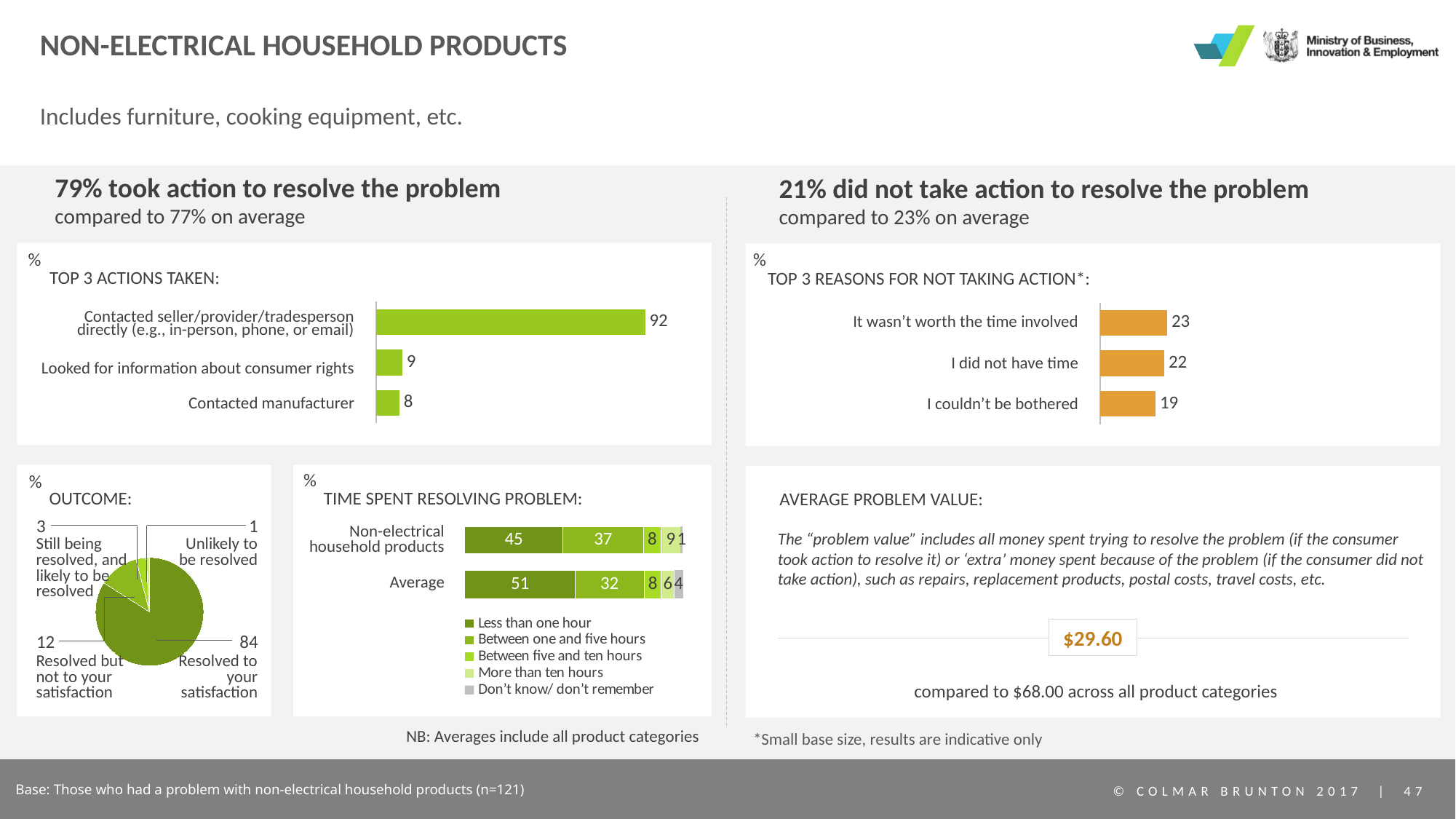
In the 'OUTCOME' pie chart, which outcome has the smallest slice? Unlikely to be resolved In the 'TOP 3 ACTIONS TAKEN' chart, what is the value for 'Contacted seller/provider/tradesperson directly'? 92 In the 'TOP 3 ACTIONS TAKEN' chart, which action has the lowest value? Contacted manufacturer What kind of chart is the 'OUTCOME' chart? Pie chart In the 'TOP 3 ACTIONS TAKEN' chart, what is the difference between 'Contacted seller/provider/tradesperson directly' and 'Looked for information about consumer rights'? 83 In the 'TIME SPENT RESOLVING PROBLEM' chart, what is the value for 'Less than one hour' for Non-electrical household products? 45 In the 'TIME SPENT RESOLVING PROBLEM' chart, how many series does the legend list? 5 In the 'TIME SPENT RESOLVING PROBLEM' chart, which is larger for 'Between one and five hours': Non-electrical household products or Average? Non-electrical household products In the 'TOP 3 REASONS FOR NOT TAKING ACTION' chart, what is the value for 'I did not have time'? 22 In the 'OUTCOME' pie chart, what is the value for 'Resolved to your satisfaction'? 84 In the 'TOP 3 REASONS FOR NOT TAKING ACTION' chart, which reason has the highest value? It wasn't worth the time involved In the 'TOP 3 REASONS FOR NOT TAKING ACTION' chart, how many reasons are shown? 3